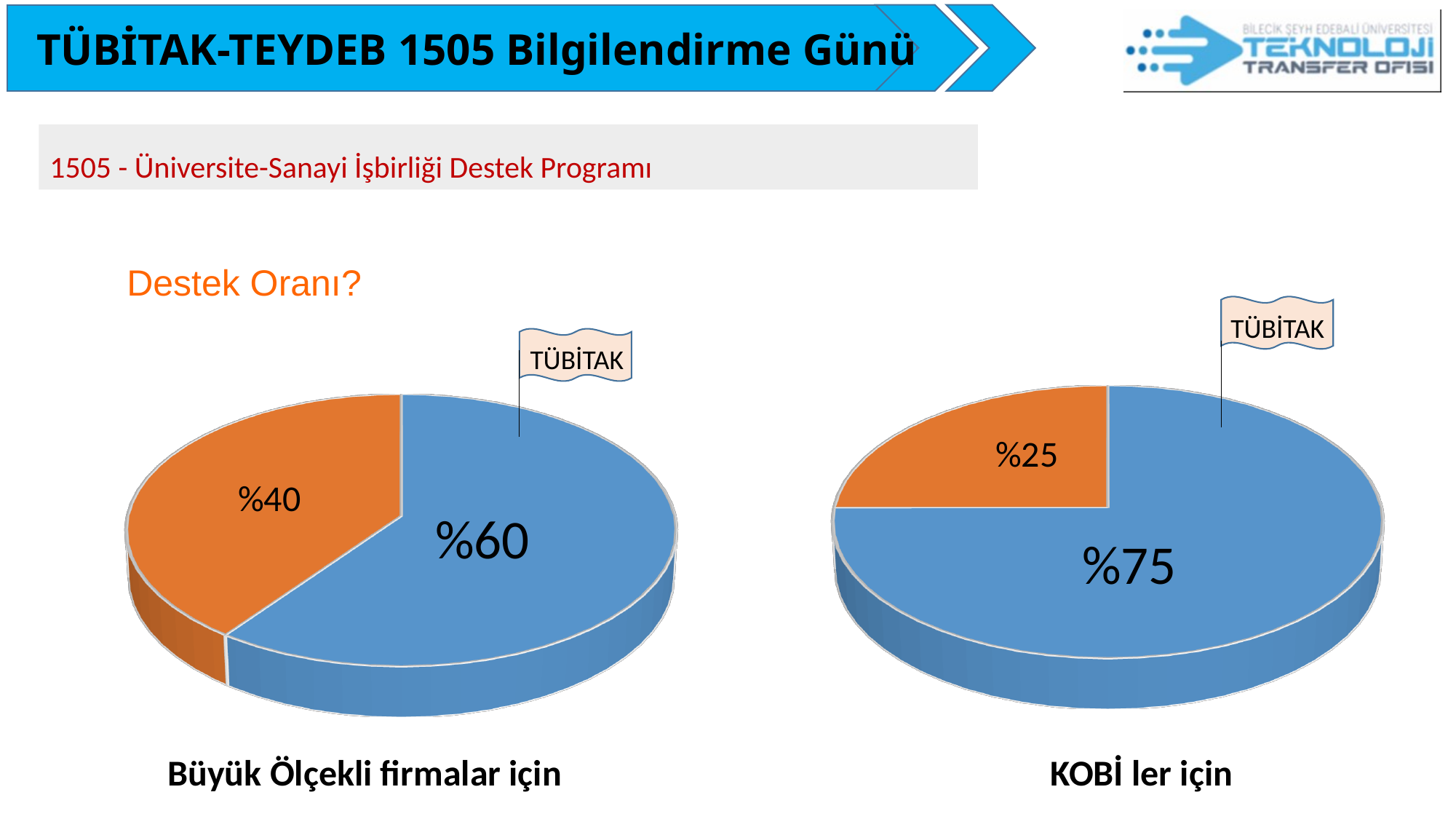
What colour is the TÜBİTAK slice in both pie charts? Blue In the left pie chart (Büyük Ölçekli firmalar için), what share is labelled TÜBİTAK? %60 In the left pie chart (Büyük Ölçekli firmalar için), what value is shown on the orange slice? %40 In the left pie chart (Büyük Ölçekli firmalar için), what is the difference between the two slices? 20 percentage points How many slices does the left pie chart (Büyük Ölçekli firmalar için) have? 2 In the right pie chart (KOBİ ler için), what share is labelled TÜBİTAK? %75 How many slices does the right pie chart (KOBİ ler için) have? 2 In the right pie chart (KOBİ ler için), which slice is the smallest? The orange slice (%25) In the left pie chart (Büyük Ölçekli firmalar için), which slice is larger, the TÜBİTAK slice or the orange slice? TÜBİTAK What kind of chart is used for Büyük Ölçekli firmalar için? Pie chart In the right pie chart (KOBİ ler için), what value is shown on the orange slice? %25 What is the difference between the TÜBİTAK share in the KOBİ ler için chart and the TÜBİTAK share in the Büyük Ölçekli firmalar için chart? 15 percentage points